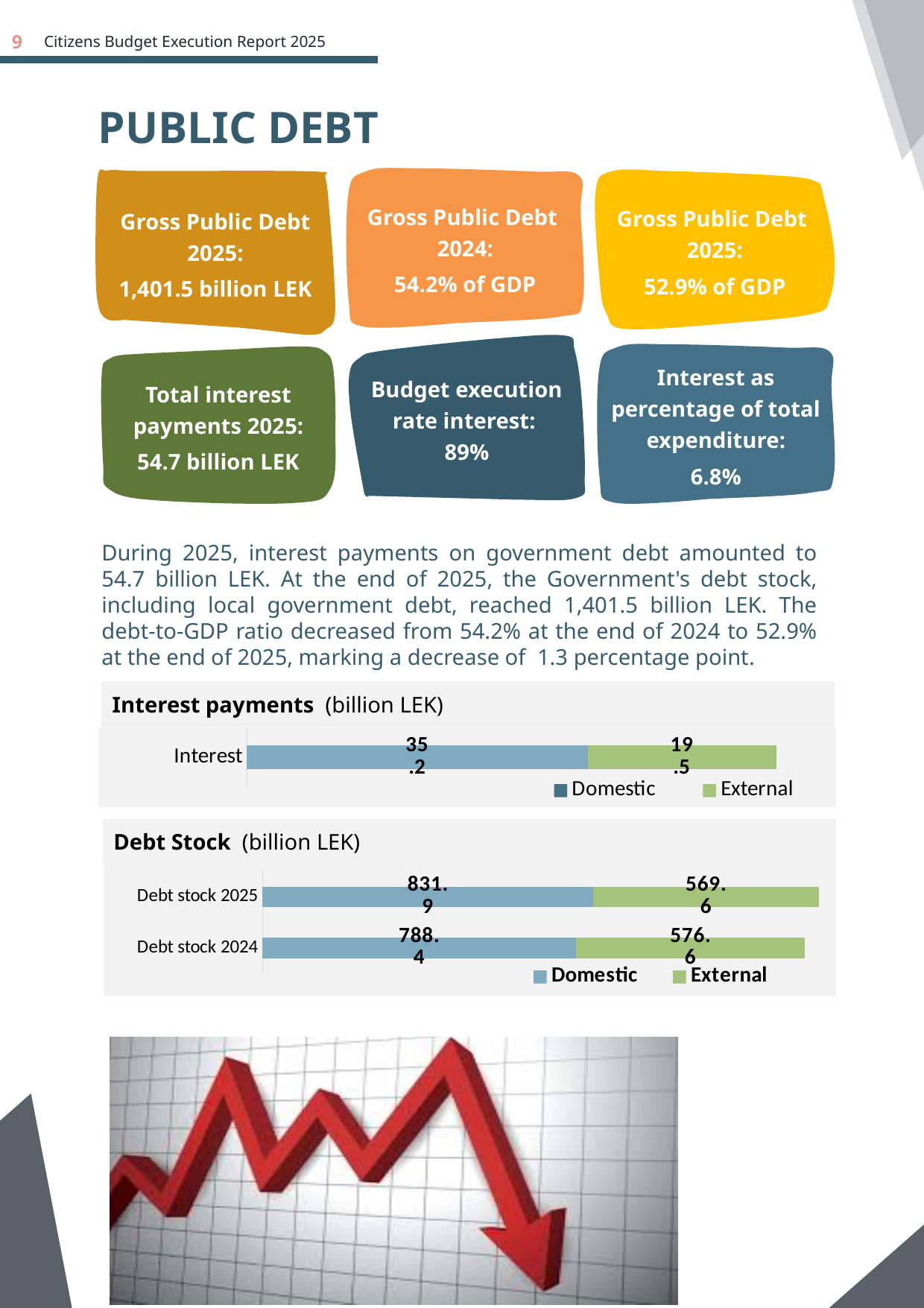
What type of chart is the Debt Stock chart? Stacked bar chart In the Interest payments chart, what is the total of the stacked Interest bar? 54.7 In the Interest payments chart, what is the difference between the Domestic and External values? 15.7 In the Interest payments chart, which is larger, Domestic or External? Domestic In the Debt Stock chart, how many series does the legend list? 2 In the Debt Stock chart, what is the total of the Debt stock 2025 bar? 1,401.5 In the Debt Stock chart, by how much did the Domestic value increase from Debt stock 2024 to Debt stock 2025? 43.5 In the Debt Stock chart, what is the External value for Debt stock 2024? 576.6 In the Debt Stock chart, what is the Domestic value for Debt stock 2025? 831.9 In the Interest payments chart, what is the Domestic value? 35.2 In the Interest payments chart, what is the External value? 19.5 In the Debt Stock chart, how many categories are shown? 2